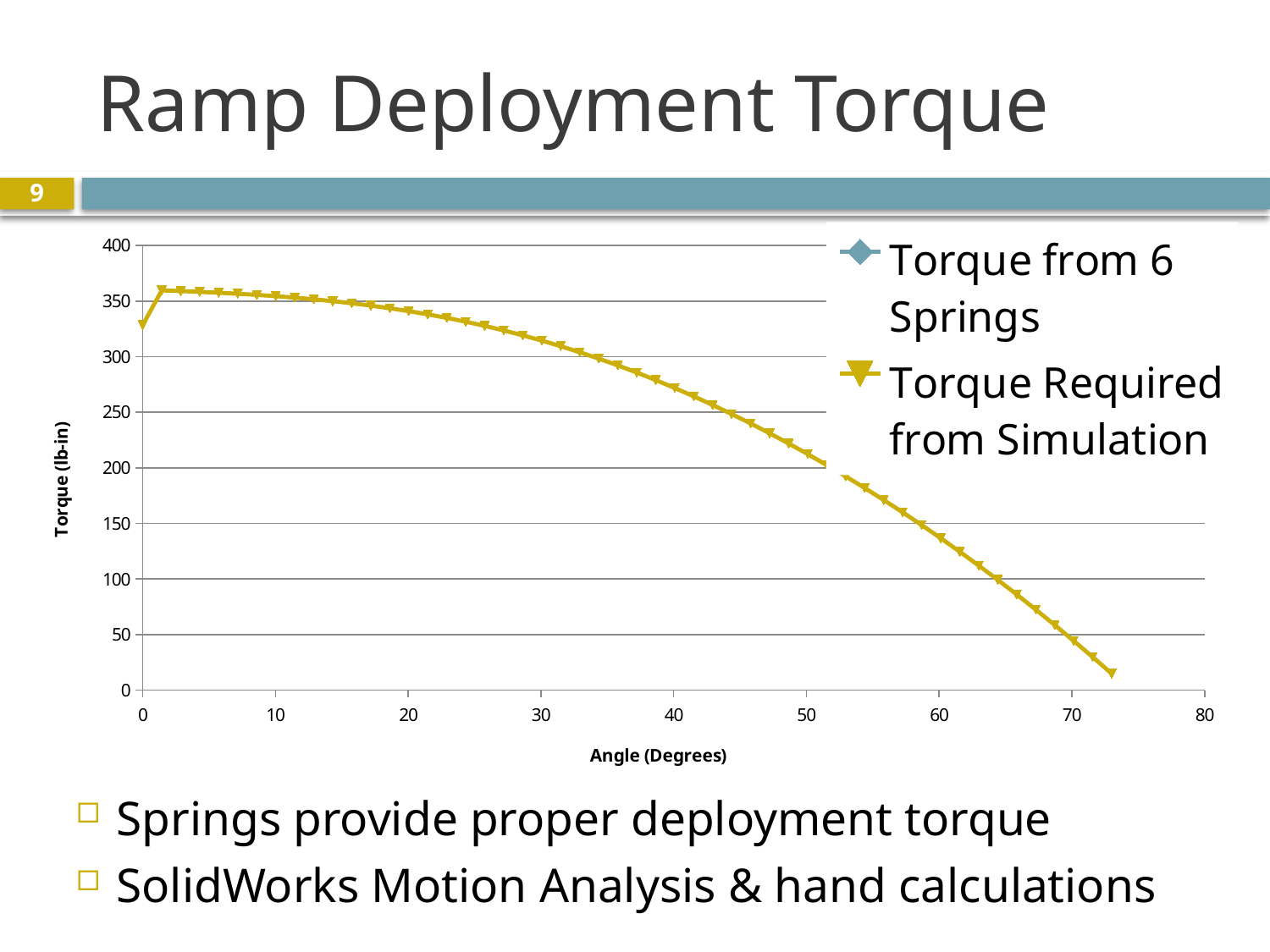
What is the highest value shown on the vertical axis of the chart? 400 Overall, does the Torque Required from Simulation rise or fall as the angle increases from 10 to 70 degrees? Fall What are the two series named in the chart legend? Torque from 6 Springs; Torque Required from Simulation Is the Torque Required from Simulation value at an angle of 70 degrees greater or less than 100? less What is the label of the vertical axis of the chart? Torque (lb-in) Is the Torque Required from Simulation value at an angle of 0 degrees greater or less than 300? greater Which is larger for Torque Required from Simulation: the value at 20 degrees or the value at 60 degrees? 20 degrees Is the Torque Required from Simulation value at an angle of 50 degrees greater or less than 250? less How many series does the chart legend list? 2 What kind of chart is shown on the slide? Line chart